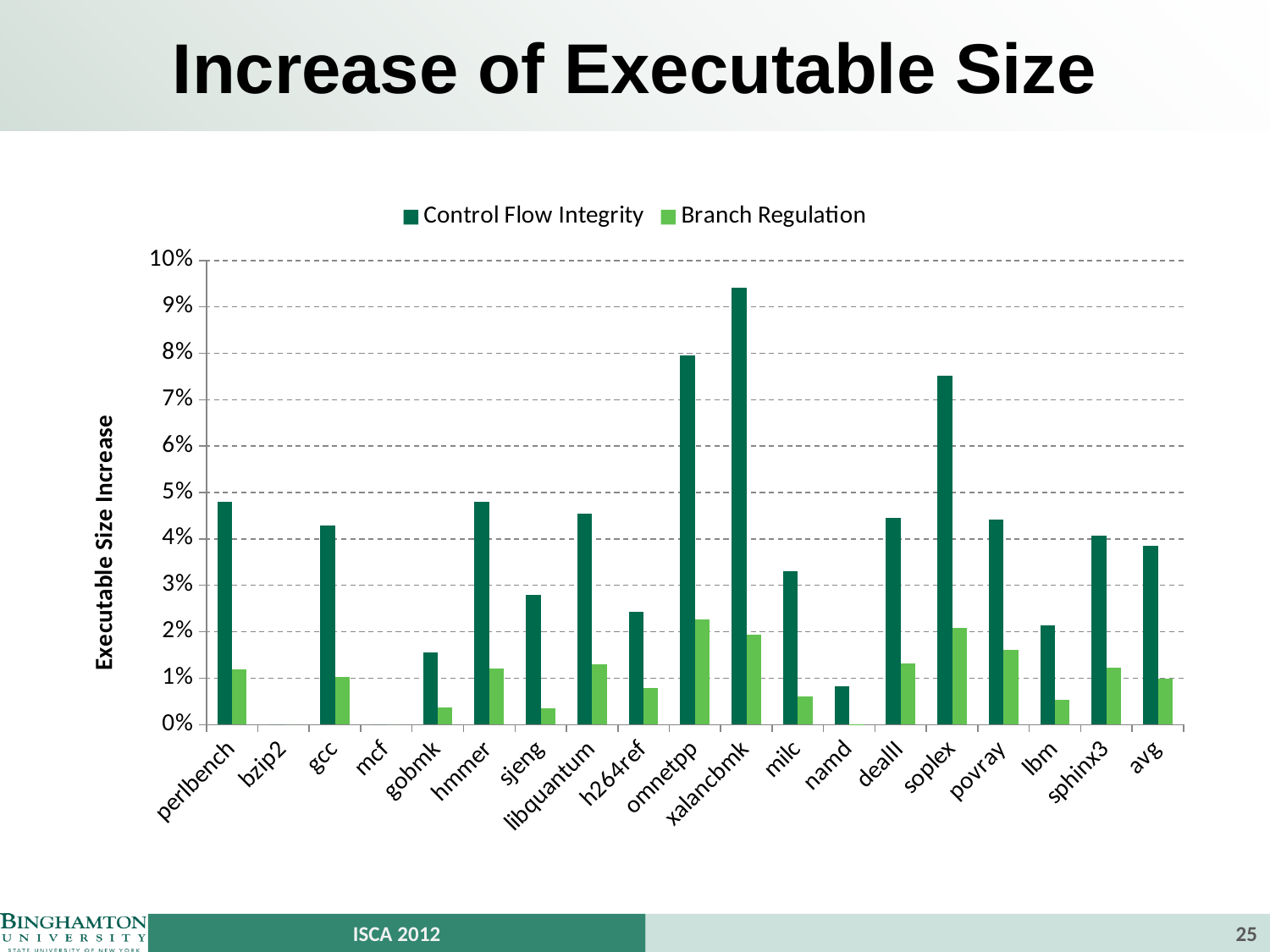
Is the Control Flow Integrity value for milc greater or less than 3%? greater Is the Branch Regulation value for omnetpp greater or less than 2%? greater Is the Control Flow Integrity value for soplex greater or less than 7%? greater How many benchmark categories are shown along the x axis? 19 What kind of chart is shown on the slide? bar chart How many series does the legend list? 2 Which is larger, the Control Flow Integrity value for omnetpp or for soplex? omnetpp Which is larger, the Control Flow Integrity value for perlbench or for gcc? perlbench What is the label of the vertical axis? Executable Size Increase Which benchmark has the highest Control Flow Integrity value? xalancbmk